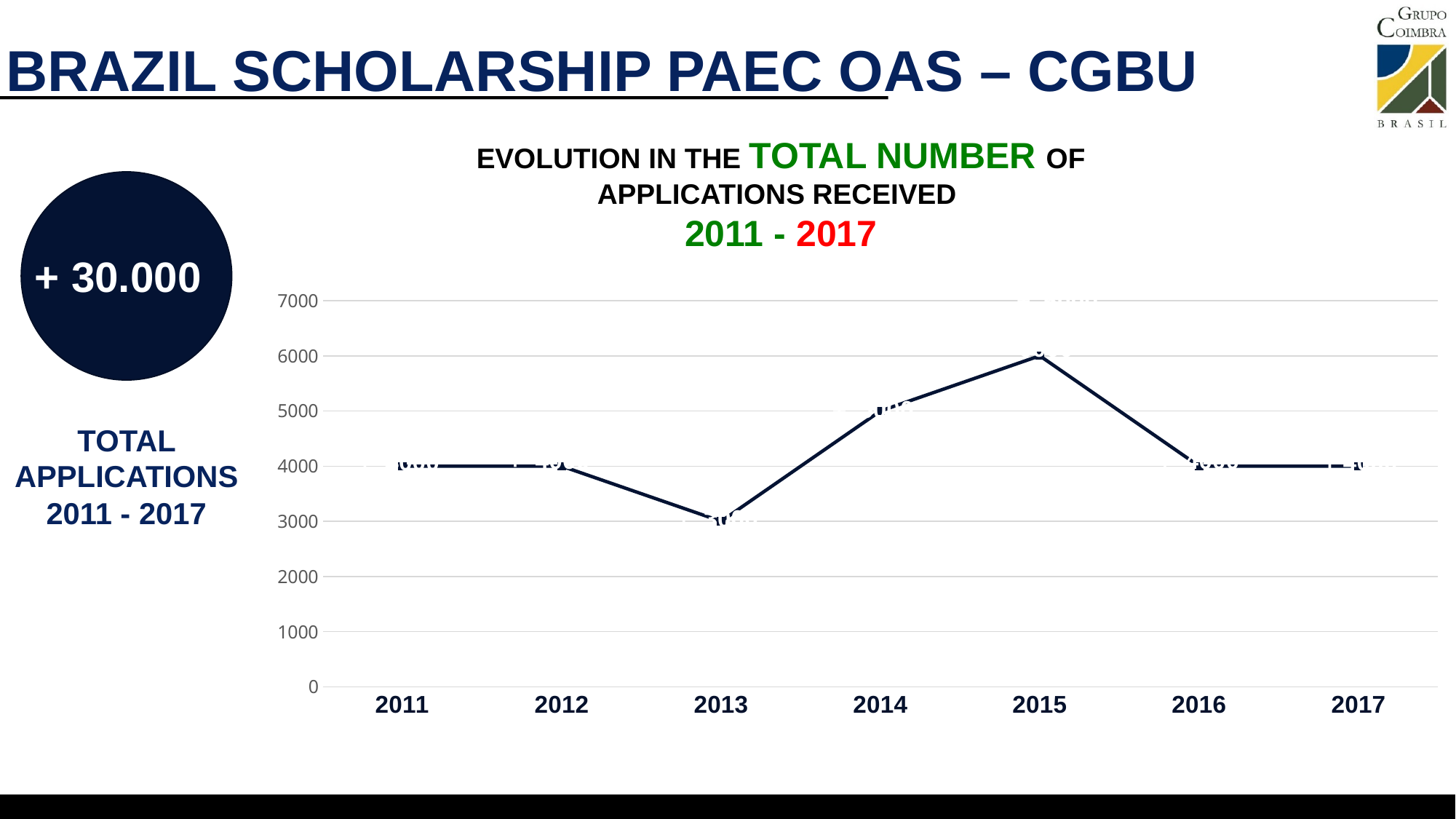
How many years are plotted on the x axis of the chart? 7 What kind of chart is shown on the slide? line chart Is the value for 2014 greater or less than 4000? greater Is the value for 2013 greater or less than 4000? less Do the values rise or fall from 2013 to 2015? rise Do the values rise or fall from 2015 to 2016? fall Is the value for 2015 greater or less than 7000? less What period does the chart title say the evolution covers? 2011 - 2017 Which year has the lowest number of applications received? 2013 Which year has more applications received, 2014 or 2013? 2014 Which year has the highest number of applications received? 2015